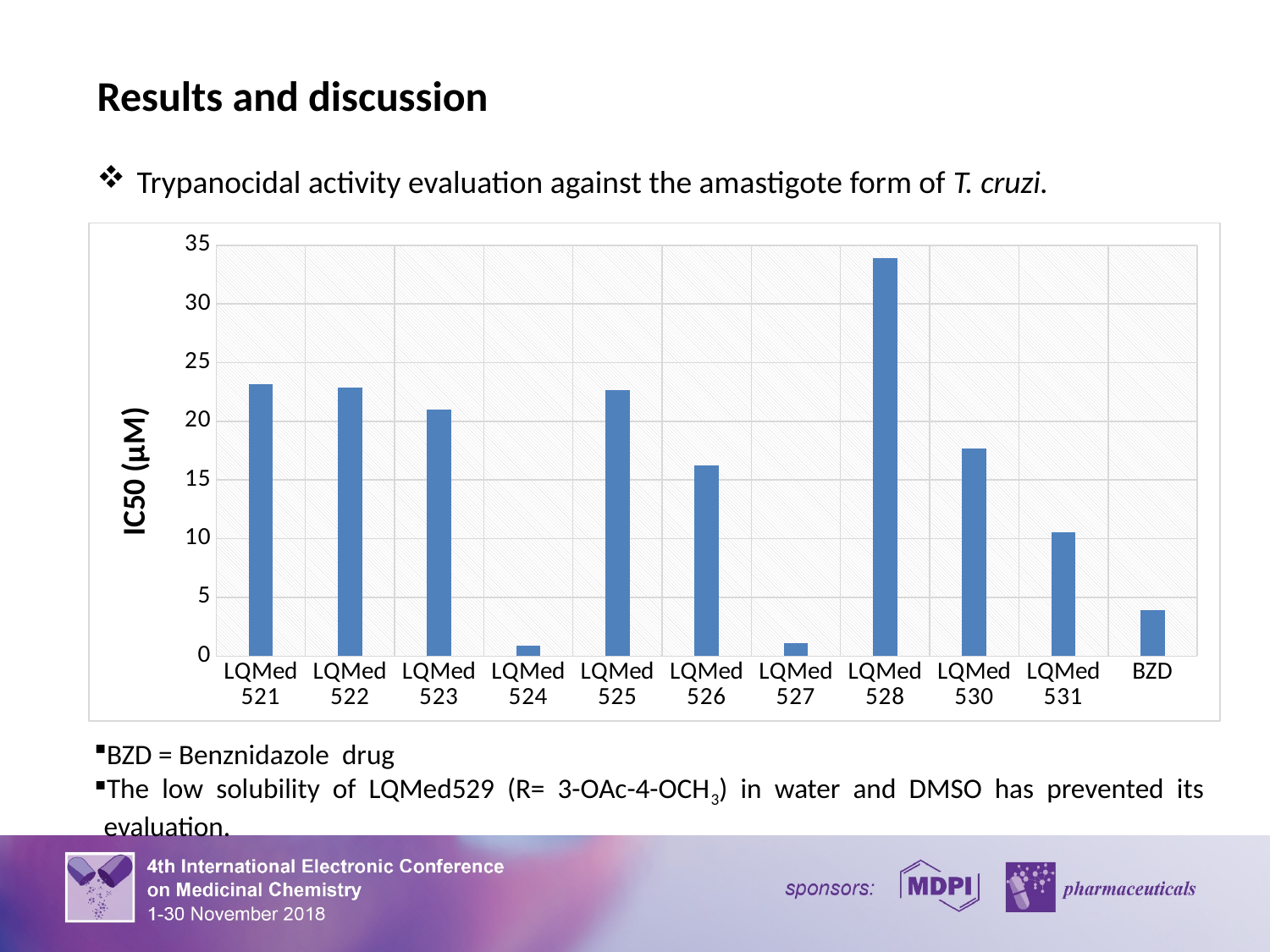
Is the value for LQMed 530 greater or less than 20? less How many categories are plotted on the x axis of the chart? 11 Is the value for BZD greater or less than 5? less Which has the larger IC50 value, LQMed 528 or LQMed 521? LQMed 528 Which category has the highest IC50 value in the chart? LQMed 528 Is the value for LQMed 524 greater or less than 5? less What is the label of the y axis of the chart? IC50 (µM) What kind of chart is shown on the slide? bar chart Which has the larger IC50 value, LQMed 531 or BZD? LQMed 531